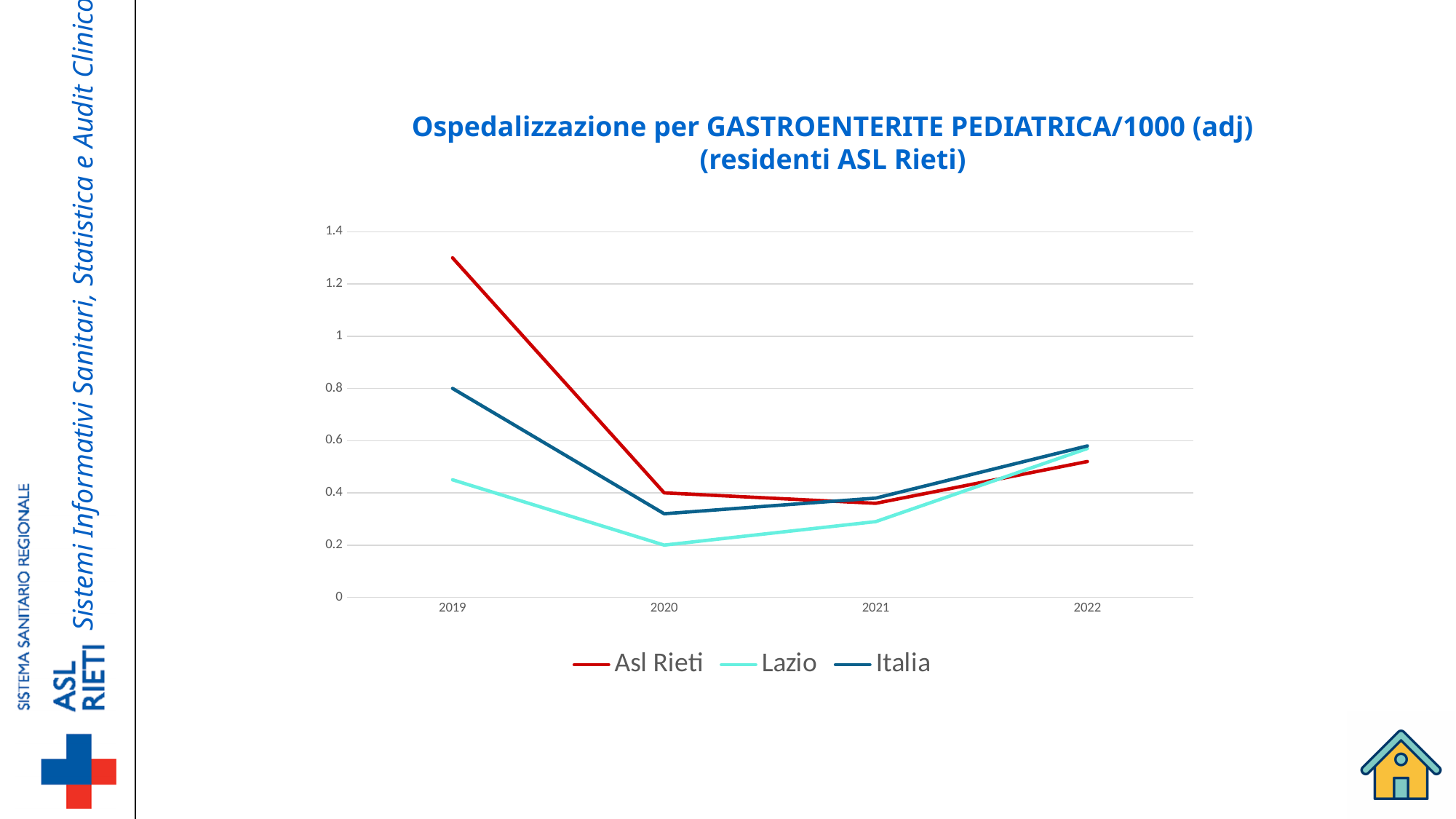
Does the Asl Rieti line rise or fall from 2019 to 2020? fall Which series has the lowest value in 2020? Lazio Is the value for Asl Rieti in 2019 greater or less than 1.2? greater What is the title of the chart? Ospedalizzazione per GASTROENTERITE PEDIATRICA/1000 (adj) (residenti ASL Rieti) Does the Lazio line rise or fall from 2020 to 2022? rise Is the value for Lazio in 2019 greater or less than 0.6? less In 2021, which is larger: the value for Italia or the value for Lazio? Italia How many series does the legend list? 3 How many years are plotted along the x axis? 4 Is the value for Italia in 2020 greater or less than 0.4? less What kind of chart is shown on the slide? line chart Which series has the highest value in 2019? Asl Rieti